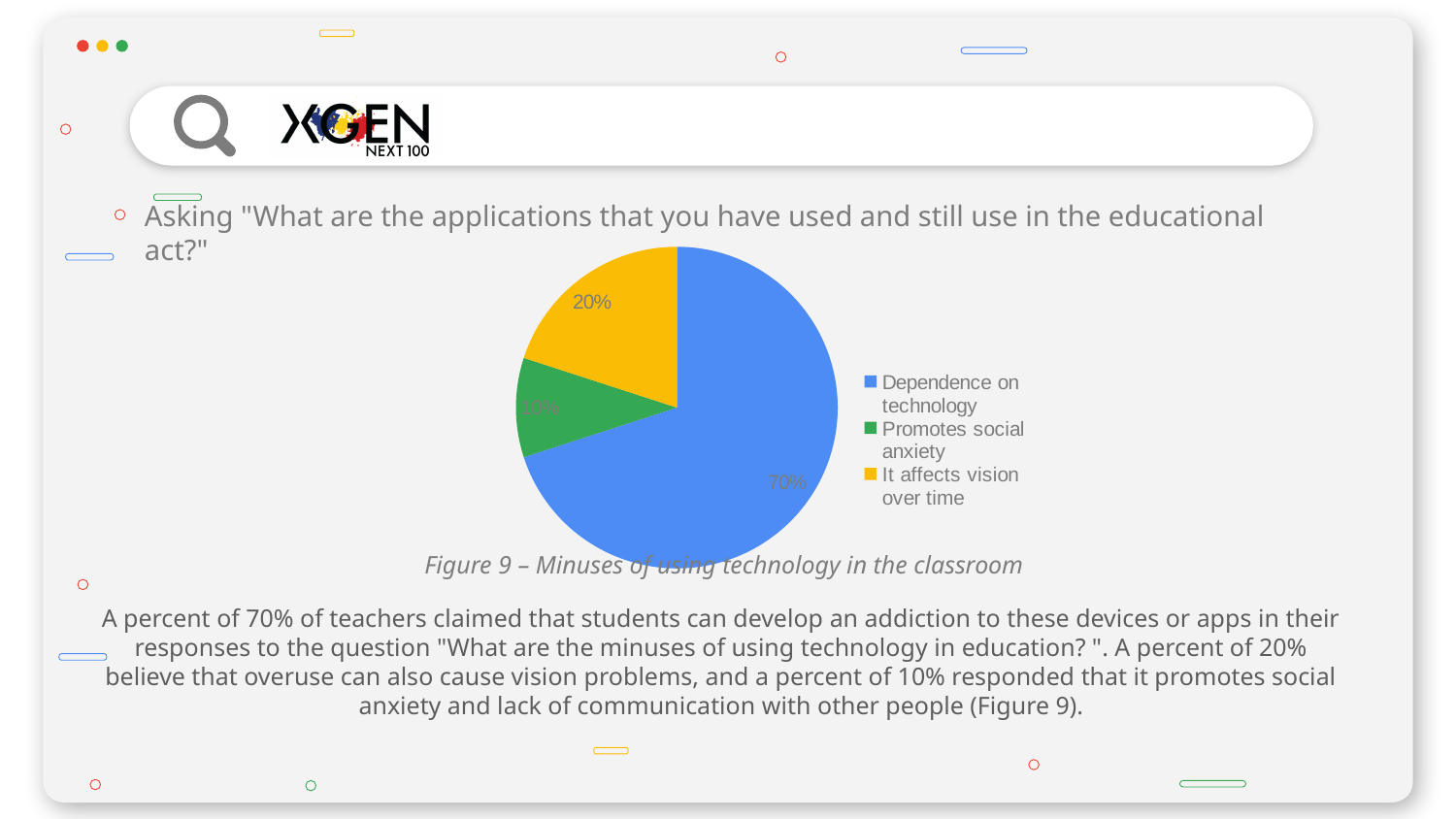
What percentage of the pie is labelled for "Promotes social anxiety"? 10% How many entries does the legend list? 3 What kind of chart is shown on the slide? pie chart How many slices does the pie chart have? 3 Which is larger: the slice for "It affects vision over time" or the slice for "Promotes social anxiety"? It affects vision over time What is the figure caption below the chart? Figure 9 – Minuses of using technology in the classroom What percentage of the pie is labelled for "It affects vision over time"? 20% Which category has the smallest slice of the pie? Promotes social anxiety What percentage of the pie is labelled for "Dependence on technology"? 70% What is the difference in percentage points between "Dependence on technology" and "It affects vision over time"? 50 Which category has the largest slice of the pie? Dependence on technology What colour is the slice for "Promotes social anxiety"? green